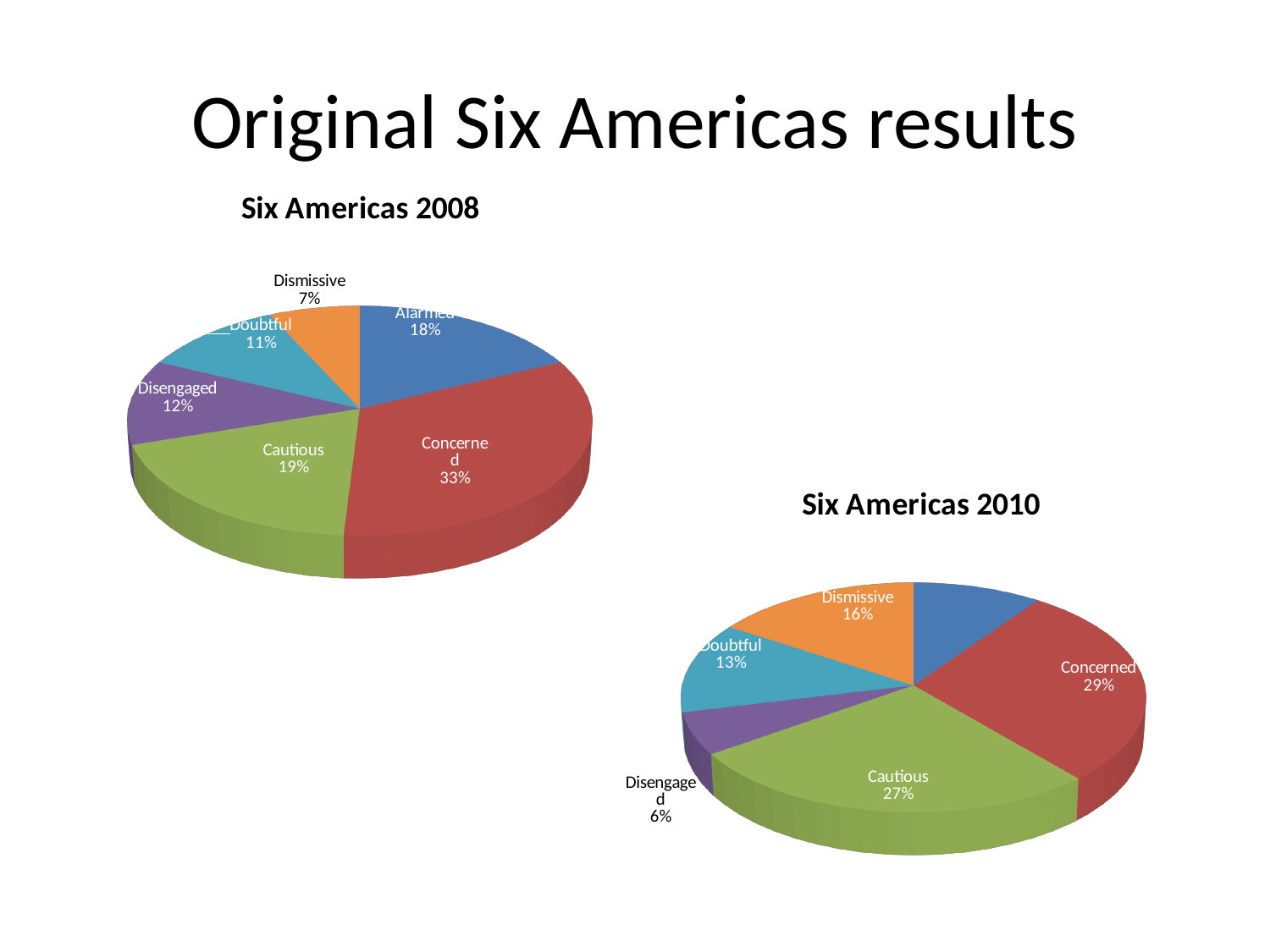
In the Six Americas 2010 chart, which labelled category has the smallest share? Disengaged In the Six Americas 2010 chart, what share is labelled for Cautious? 27% What kind of chart is the Six Americas 2010 chart? Pie chart In the Six Americas 2010 chart, which is larger, Concerned or Cautious? Concerned In the Six Americas 2008 chart, what share is labelled for Concerned? 33% In the Six Americas 2008 chart, what is the difference between the Concerned and Cautious shares? 14% In the Six Americas 2008 chart, which labelled category has the largest share? Concerned In the Six Americas 2008 chart, what share is labelled for Dismissive? 7% In the Six Americas 2008 chart, which labelled category has the smallest share? Dismissive In the Six Americas 2010 chart, what share is labelled for Disengaged? 6% In the Six Americas 2010 chart, what is the difference between the Dismissive and Doubtful shares? 3% How many slices does the Six Americas 2008 chart have? 6